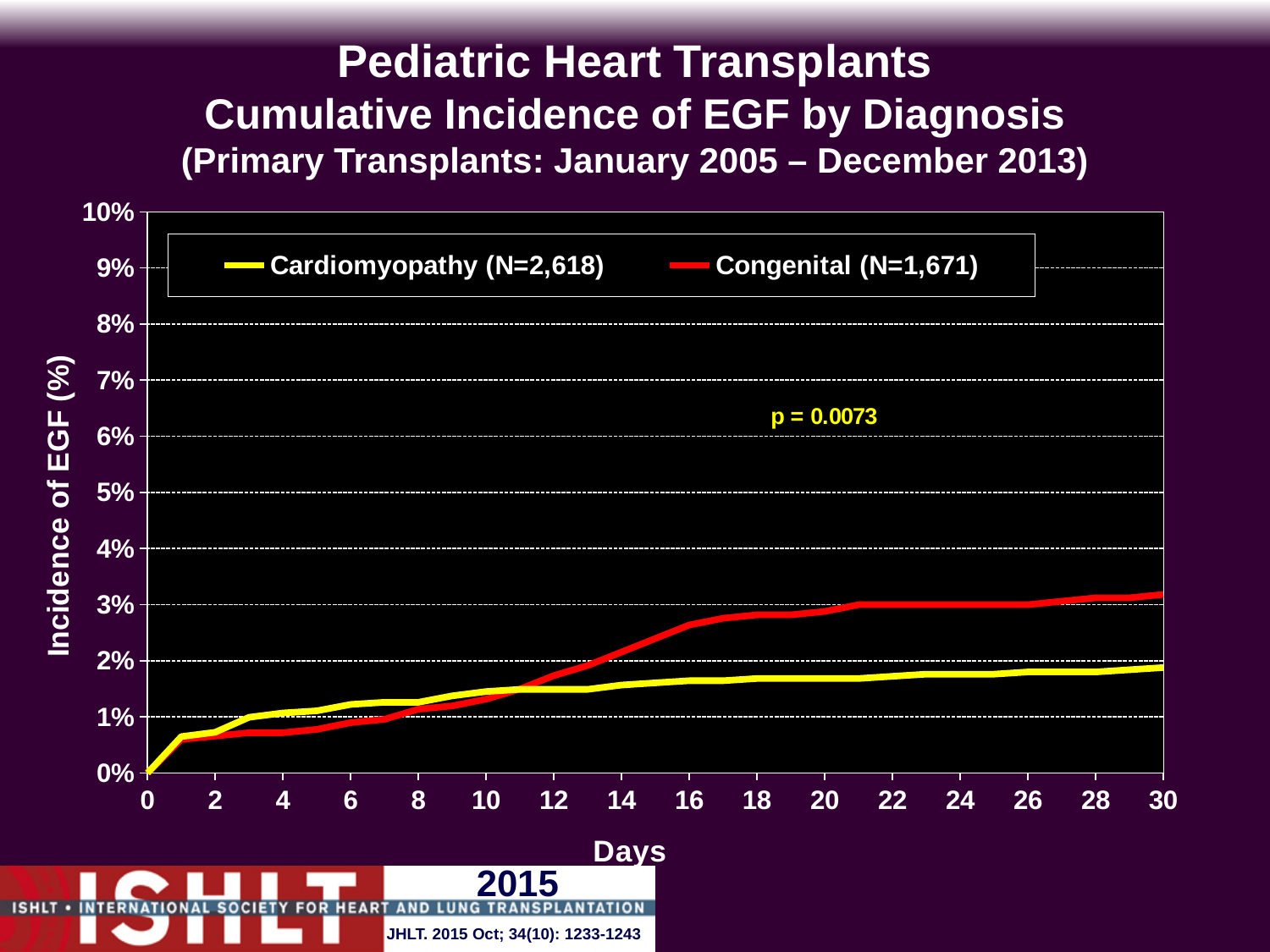
What is the highest value shown on the y axis? 10% At day 30, which series has the higher cumulative incidence of EGF, Cardiomyopathy or Congenital? Congenital Is the value for Congenital at day 30 greater or less than 2%? greater At day 4, which series has the higher cumulative incidence of EGF, Cardiomyopathy or Congenital? Cardiomyopathy Is the value for Cardiomyopathy at day 30 greater or less than 3%? less How many series does the legend list? 2 Does the cumulative incidence of EGF for the Congenital series rise or fall as days increase from 0 to 30? Rise Is the value for Congenital at day 2 greater or less than 1%? less What kind of chart is shown on the slide? Line chart What p-value is printed on the chart? p = 0.0073 What is the sample size (N) shown in the legend for the Cardiomyopathy series? N=2,618